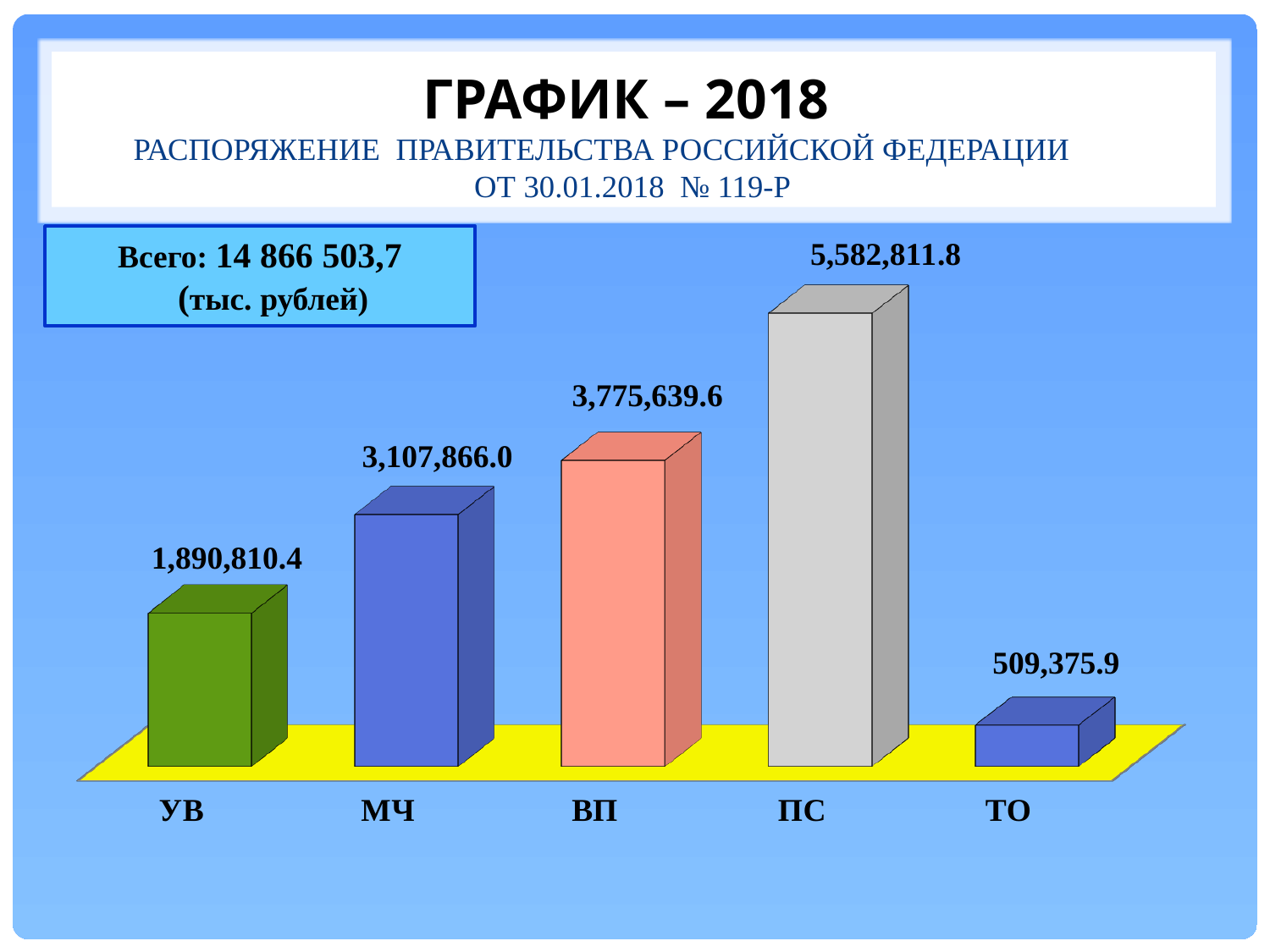
What is the difference between the values for ПС and ВП? 1,807,172.2 Which category has the highest value? ПС What is the difference between the values for ВП and МЧ? 667,773.6 What is the value for ТО? 509,375.9 Which is larger, the value for МЧ or the value for ВП? ВП Which category has the lowest value? ТО What is the value for ПС? 5,582,811.8 What total (Всего) is stated in the box on the slide? 14 866 503,7 (тыс. рублей) Do the values rise or fall from УВ to ПС along the x axis? rise What kind of chart is shown on the slide? bar chart What is the value for УВ? 1,890,810.4 How many categories are shown in the chart? 5